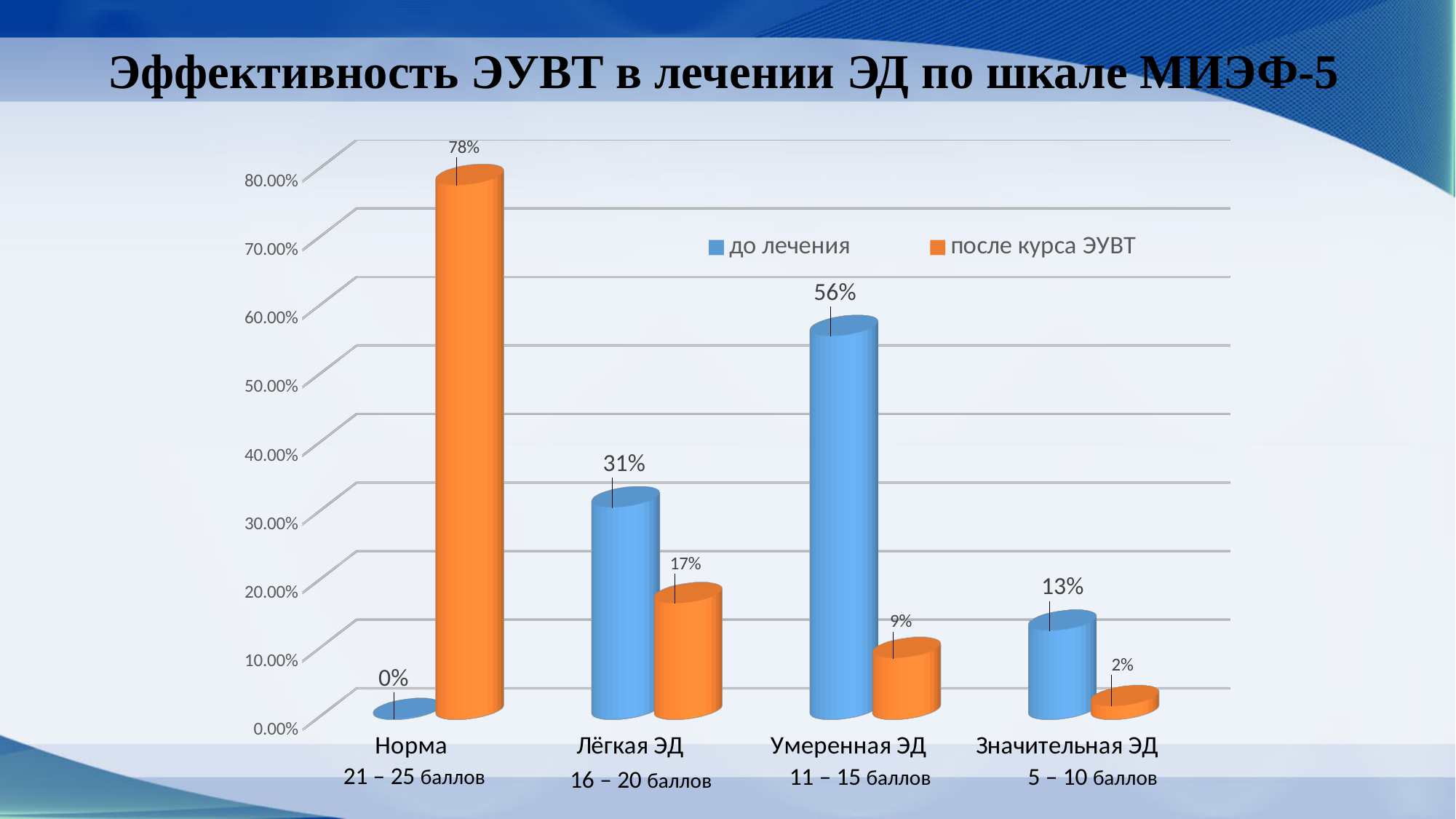
Which category has the lowest value in the "после курса ЭУВТ" series? Значительная ЭД What is the value for "Норма" in the "после курса ЭУВТ" series? 78% What kind of chart is shown on the slide? Bar chart How many categories are shown on the x axis? 4 What is the value for "Значительная ЭД" in the "до лечения" series? 13% How many series does the legend list? 2 What is the value for "Лёгкая ЭД" in the "после курса ЭУВТ" series? 17% For "Лёгкая ЭД", which series has the larger value: "до лечения" or "после курса ЭУВТ"? до лечения What is the difference between the "до лечения" and "после курса ЭУВТ" values for "Умеренная ЭД"? 47% What is the value for "Умеренная ЭД" in the "до лечения" series? 56% What is the title of the chart on the slide? Эффективность ЭУВТ в лечении ЭД по шкале МИЭФ-5 Which category has the highest value in the "до лечения" series? Умеренная ЭД